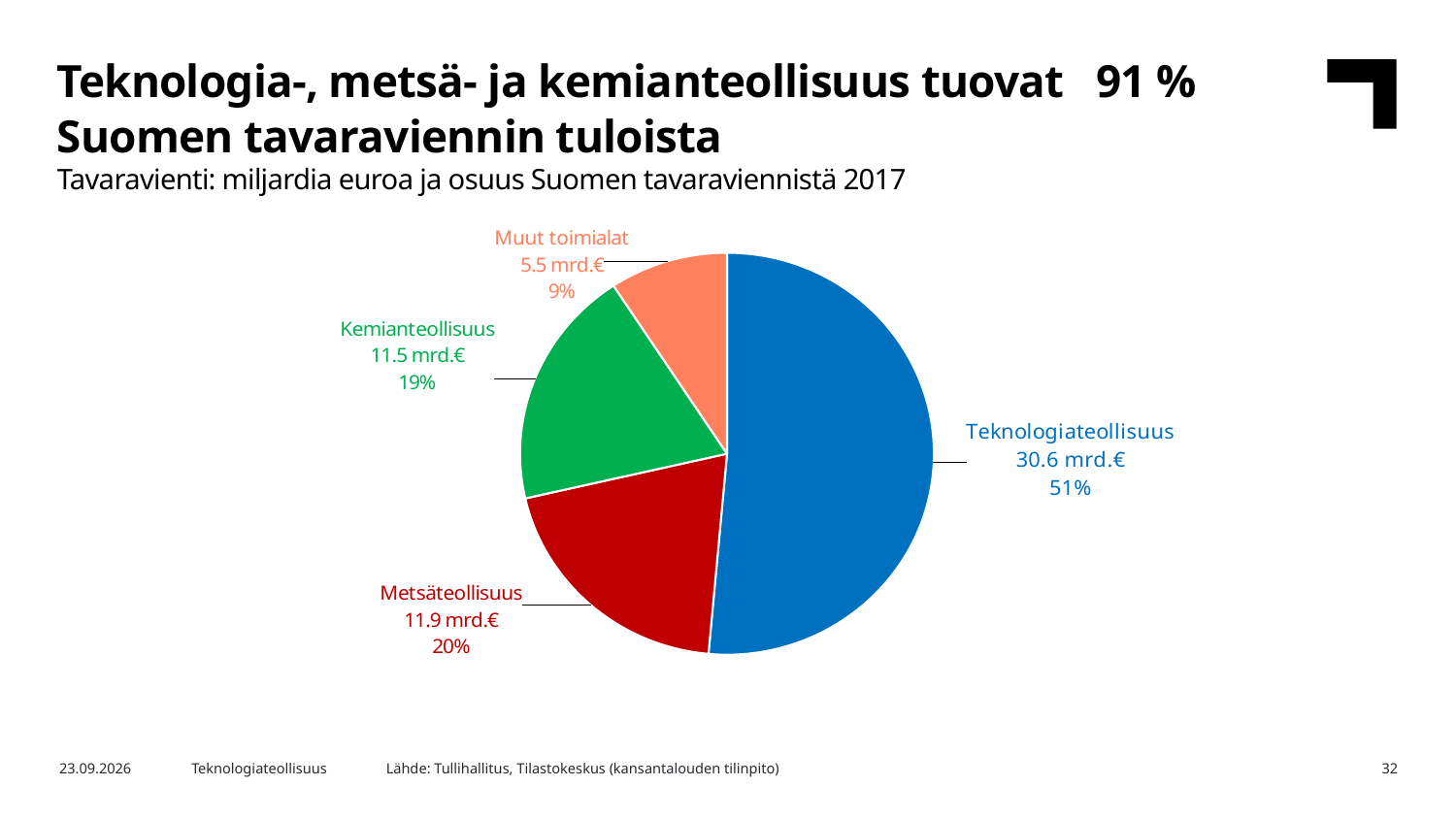
How many slices does the pie chart have? 4 What share of the pie does Teknologiateollisuus represent? 51% What share of the pie does Muut toimialat represent? 9% What is the difference in value between Teknologiateollisuus and Metsäteollisuus? 18.7 mrd.€ Which colour is used for the Kemianteollisuus slice? green Which category has the largest slice? Teknologiateollisuus What type of chart is shown on the slide? pie chart What is the value for Teknologiateollisuus? 30.6 mrd.€ What is the value for Metsäteollisuus? 11.9 mrd.€ What is the value for Kemianteollisuus? 11.5 mrd.€ Which category has the smallest slice? Muut toimialat What is the value for Muut toimialat? 5.5 mrd.€